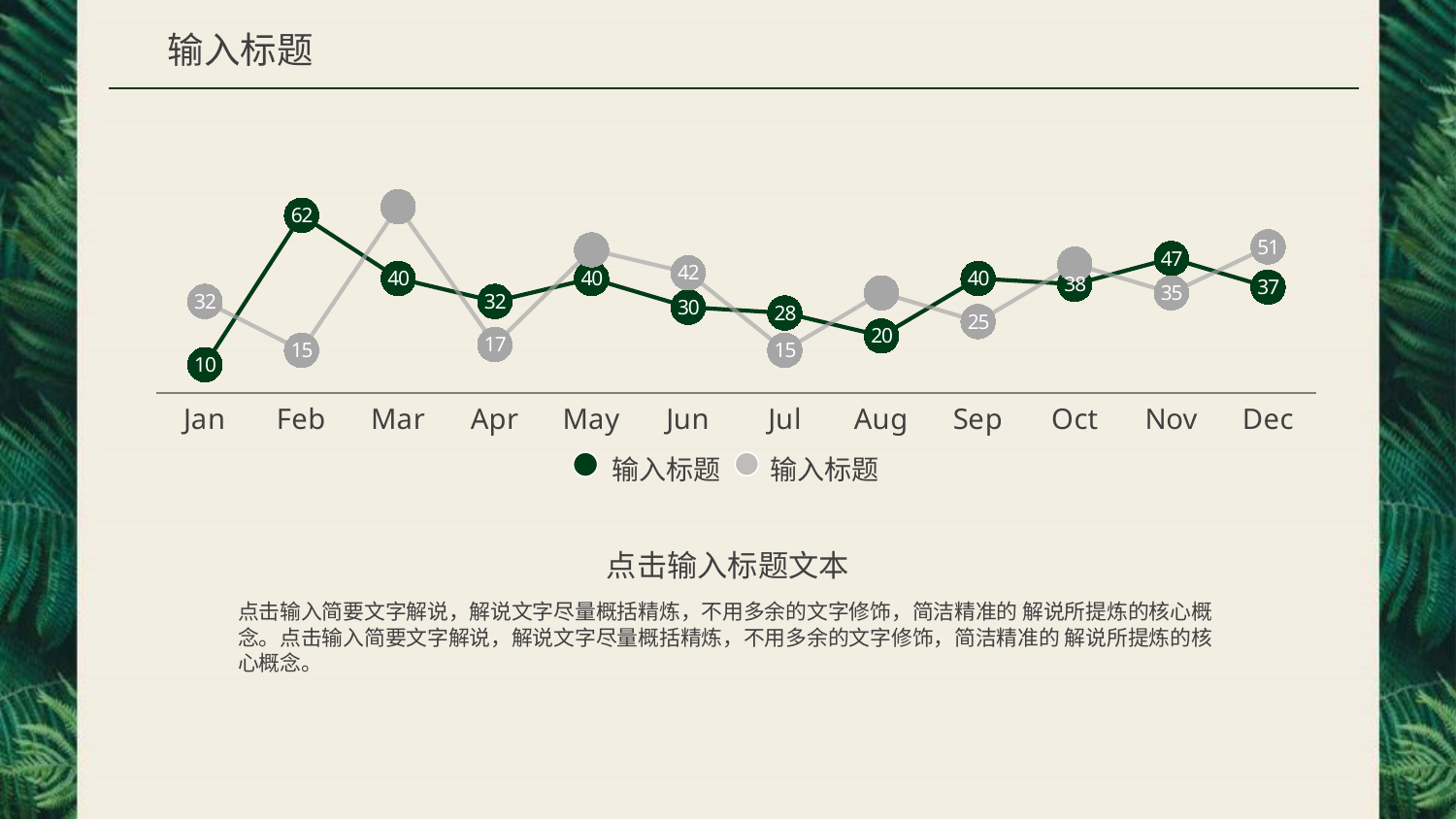
In Nov, which series has the larger value, the dark green or the gray? dark green In which month is the dark green series at its highest? Feb How many months are plotted along the x axis? 12 What is the value of the dark green series in Aug? 20 What is the difference between the dark green series values in Feb and Jan? 52 What is the value of the gray series in Dec? 51 What type of chart is shown on the slide? line chart Does the dark green series rise or fall from Jan to Feb? rise What is the value of the dark green series in Feb? 62 How many series does the legend list? 2 What is the value of the gray series in Jun? 42 In which month is the dark green series at its lowest? Jan